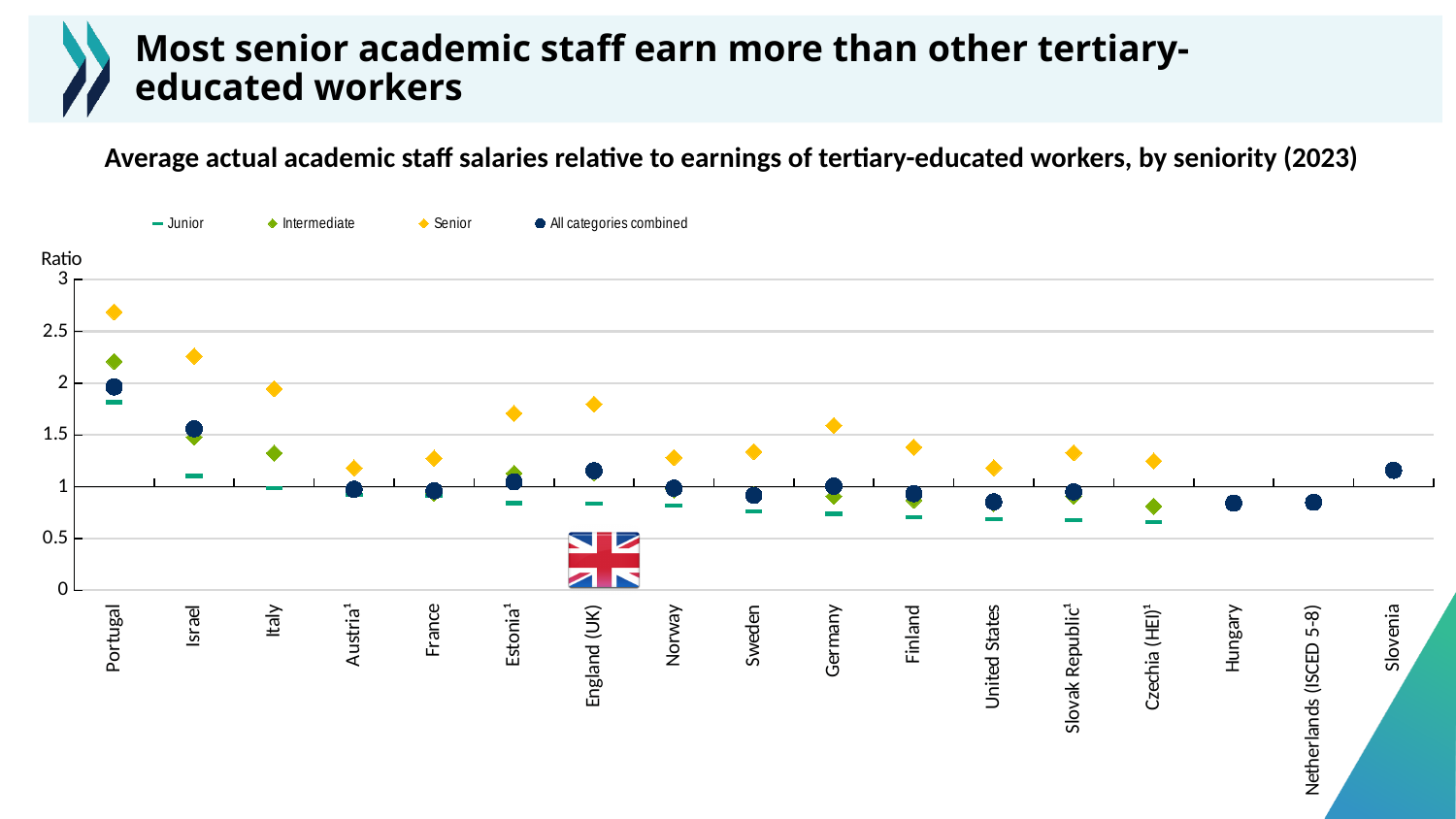
Is the All categories combined value for Hungary greater or less than 1? less Is the Intermediate value for Czechia (HEI) greater or less than 1? less What is the label on the y axis? Ratio Which is larger, the Senior value for Portugal or the Senior value for Israel? Portugal How many countries are shown on the x axis? 17 Do the Senior values generally rise or fall from left to right across the countries? fall Is the Senior value for Israel greater or less than 2? greater Which country has the highest Senior ratio? Portugal How many series does the legend list? 4 What kind of chart is this? Scatter (marker) chart